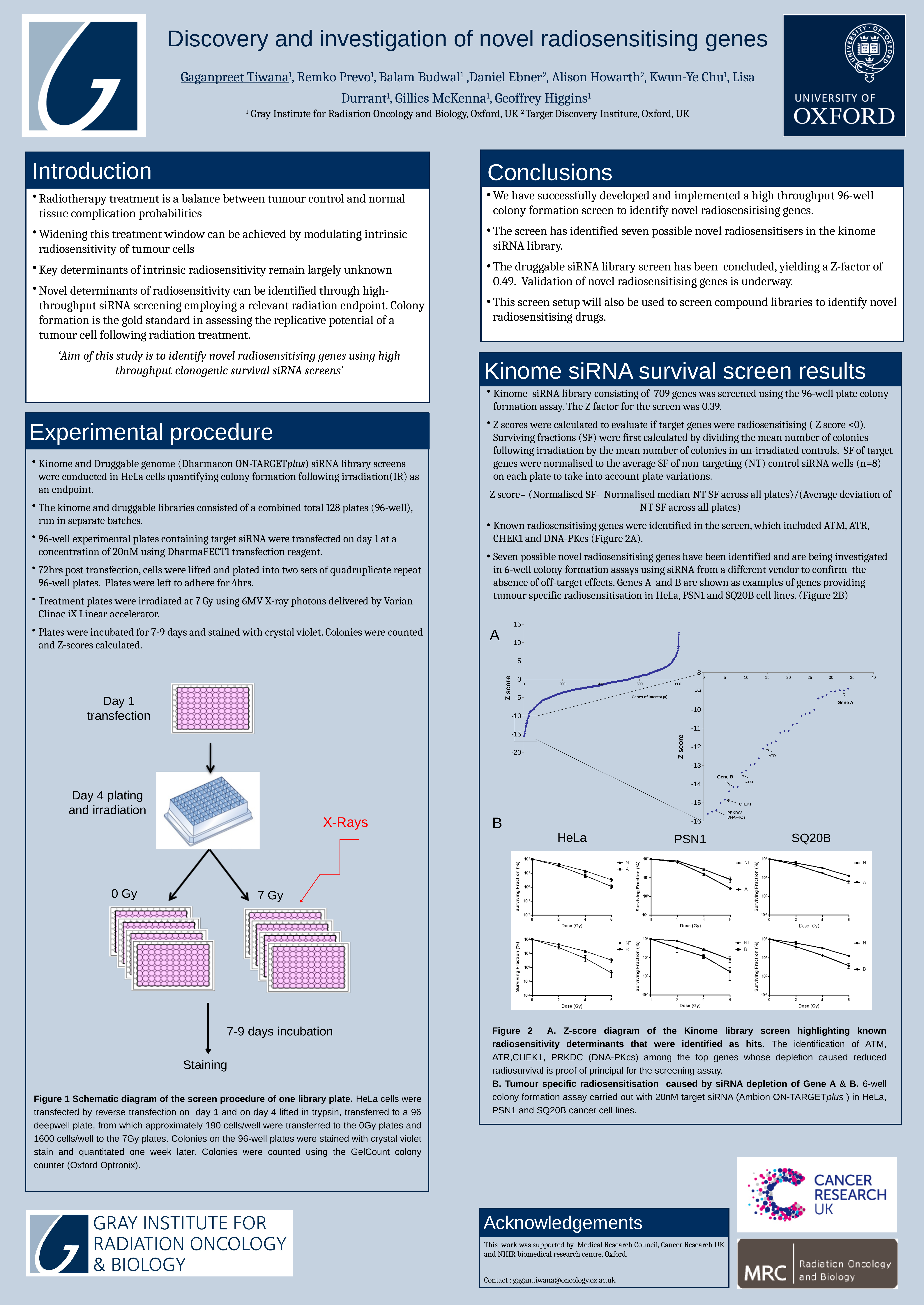
In Figure 2B, what kind of chart is used to show surviving fraction against dose? line chart In Figure 2B, how many series does the legend of the top HeLa chart list? 2 In Figure 2A, what is the label of the y axis? Z score In Figure 2B, what are the two legend entries of the bottom-row charts? NT and B In the zoomed inset of Figure 2A, which labelled gene has the highest Z score? Gene A In the zoomed inset of Figure 2A, which has the higher Z score, ATR or CHEK1? ATR In the zoomed inset of Figure 2A, is the Z score for CHEK1 greater or less than -14? less In Figure 2A, what kind of chart is the Z-score diagram of the kinome library screen? scatter plot In the zoomed inset of Figure 2A, is the Z score for Gene A greater or less than -10? greater In Figure 2B, does the surviving fraction rise or fall as the dose increases? fall In the zoomed inset of Figure 2A, which labelled gene has the lowest Z score? PRKDC/DNA-PKcs In the top HeLa chart of Figure 2B, which series has the higher surviving fraction at 6 Gy, NT or A? NT